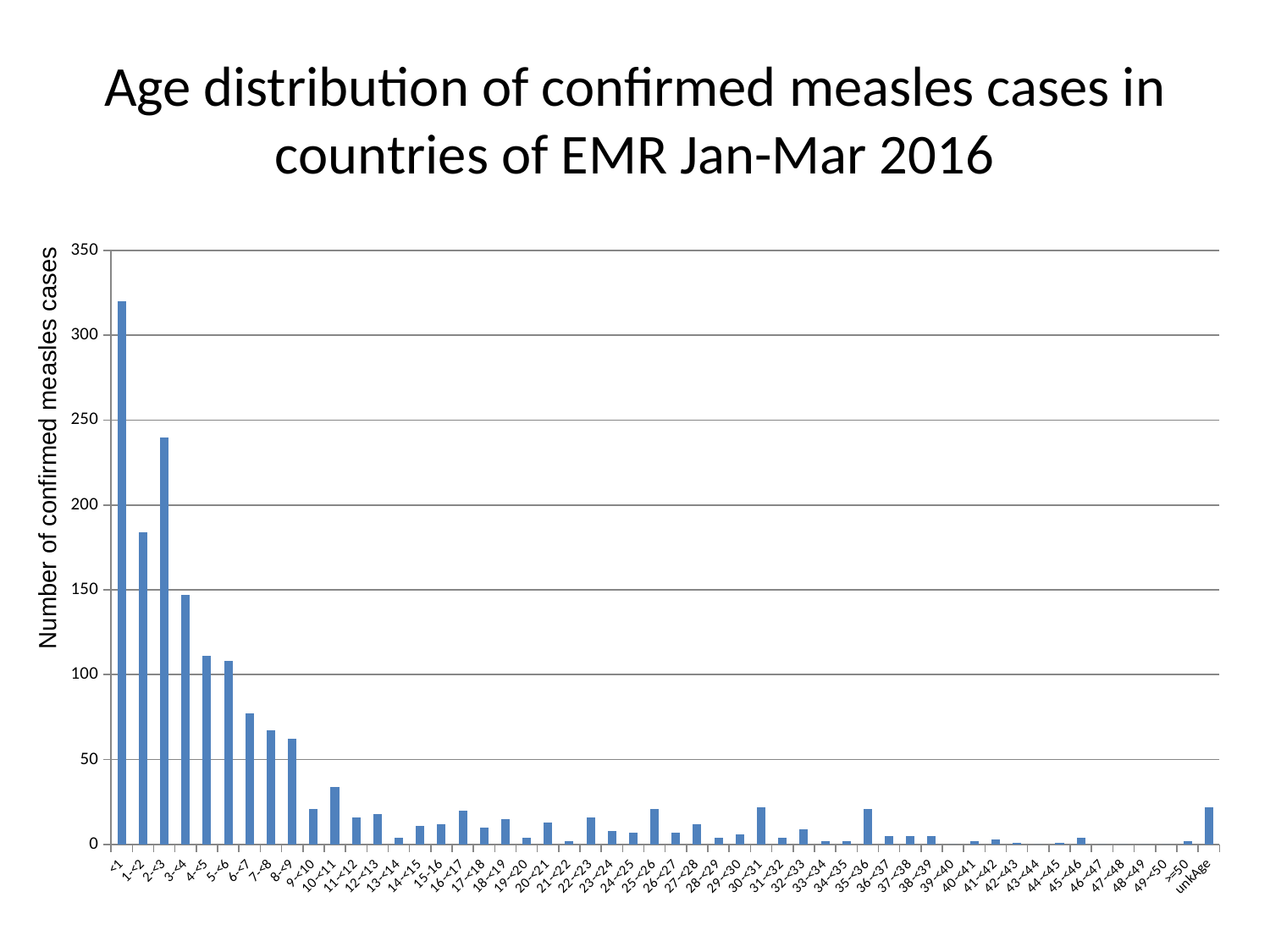
Which has more confirmed measles cases, the 1-<2 age group or the 2-<3 age group? 2-<3 Is the value for the <1 age group greater or less than 300? greater What is the label of the vertical axis? Number of confirmed measles cases Is the value for the 6-<7 age group greater or less than 100? less Overall, do the number of cases rise or fall as age increases from <1 to 9-<10? fall Is the value for the 1-<2 age group greater or less than 150? greater Which age group has the highest number of confirmed measles cases? <1 What kind of chart is shown on the slide? bar chart Which has more confirmed measles cases, the 3-<4 age group or the 7-<8 age group? 3-<4